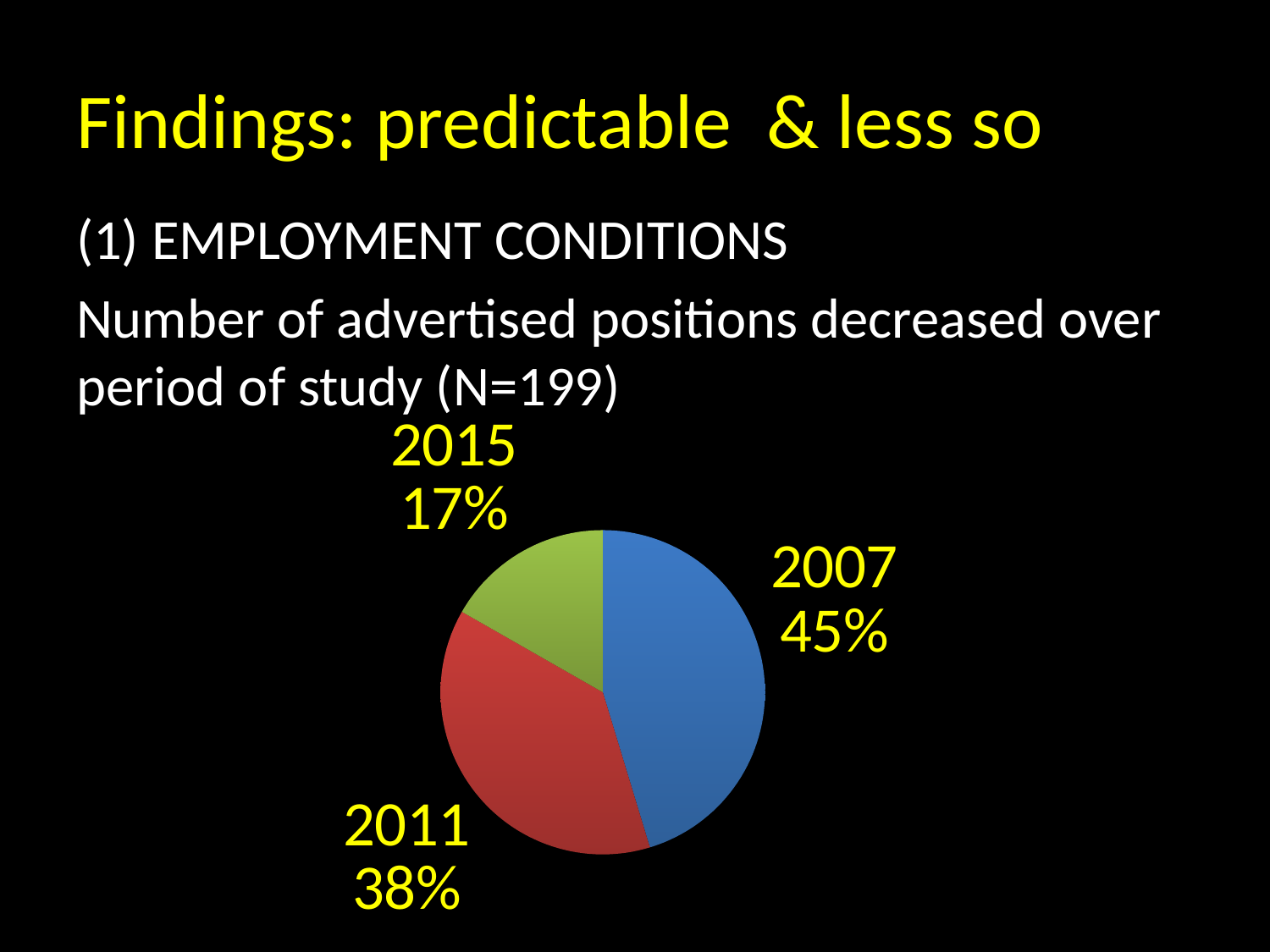
Which year has the largest slice of the pie? 2007 What share of the pie does 2015 represent? 17% How many slices does the pie chart have? 3 What share of the pie does 2007 represent? 45% What is the difference in percentage points between the 2007 and 2015 slices? 28 What kind of chart is shown on the slide? Pie chart Which slice is larger, 2011 or 2015? 2011 Which year has the smallest slice of the pie? 2015 What share of the pie does 2011 represent? 38% What is the difference in percentage points between the 2007 and 2011 slices? 7 Do the percentages decrease from 2007 to 2015? Yes What colour is the slice for 2011? Red